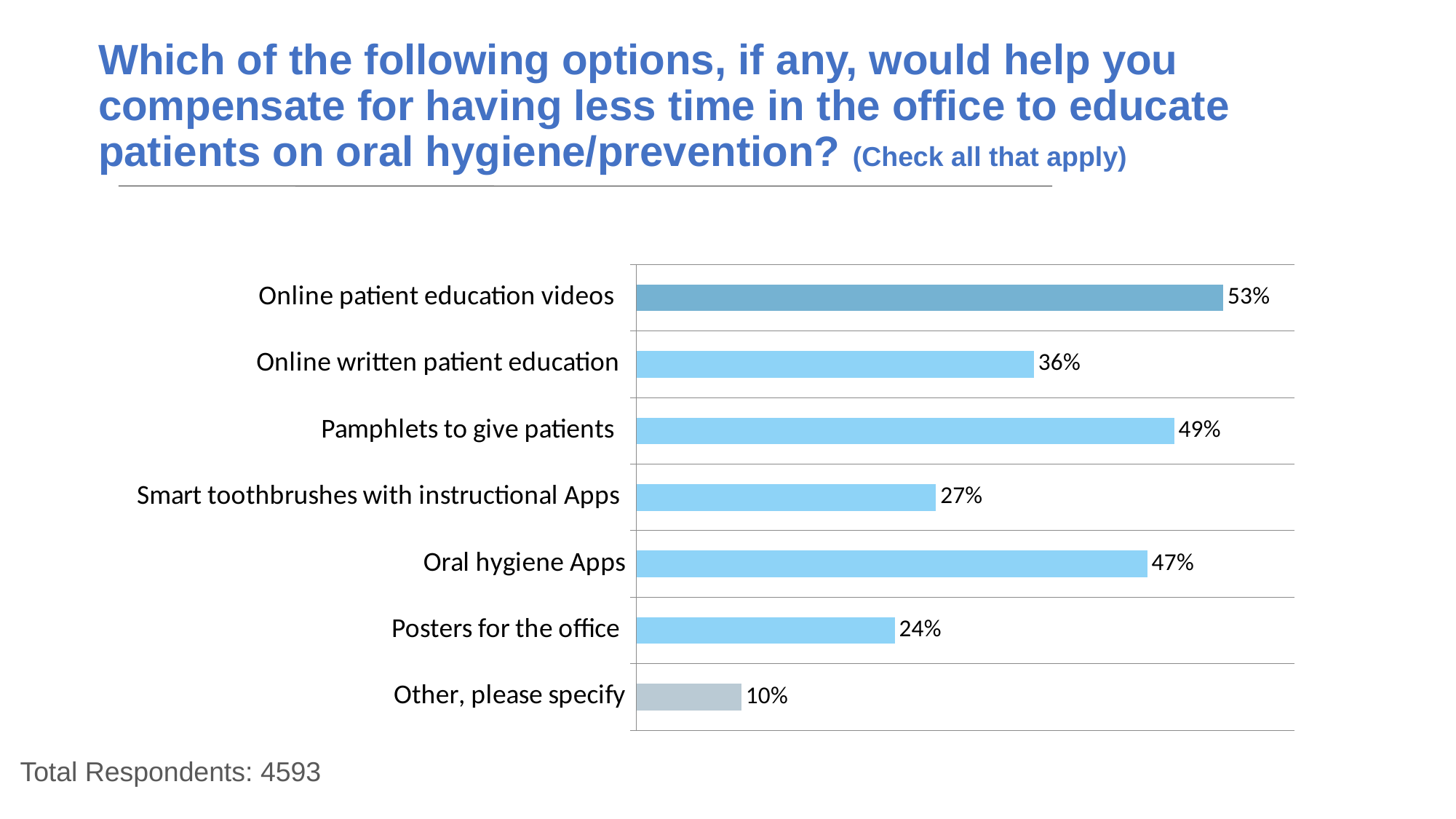
Which bar is shown in a darker blue than the others? Online patient education videos Which option has the lowest percentage of respondents? Other, please specify What is the total number of respondents stated on the slide? 4593 Which option has the highest percentage of respondents? Online patient education videos What percentage of respondents selected Smart toothbrushes with instructional Apps? 27% What percentage of respondents selected Online patient education videos? 53% What is the difference in percentage points between Online patient education videos and Online written patient education? 17 What type of chart is shown on the slide? Bar chart What percentage of respondents selected Other, please specify? 10% What percentage of respondents selected Pamphlets to give patients? 49% Which has a higher percentage: Oral hygiene Apps or Posters for the office? Oral hygiene Apps How many options are shown in the chart? 7